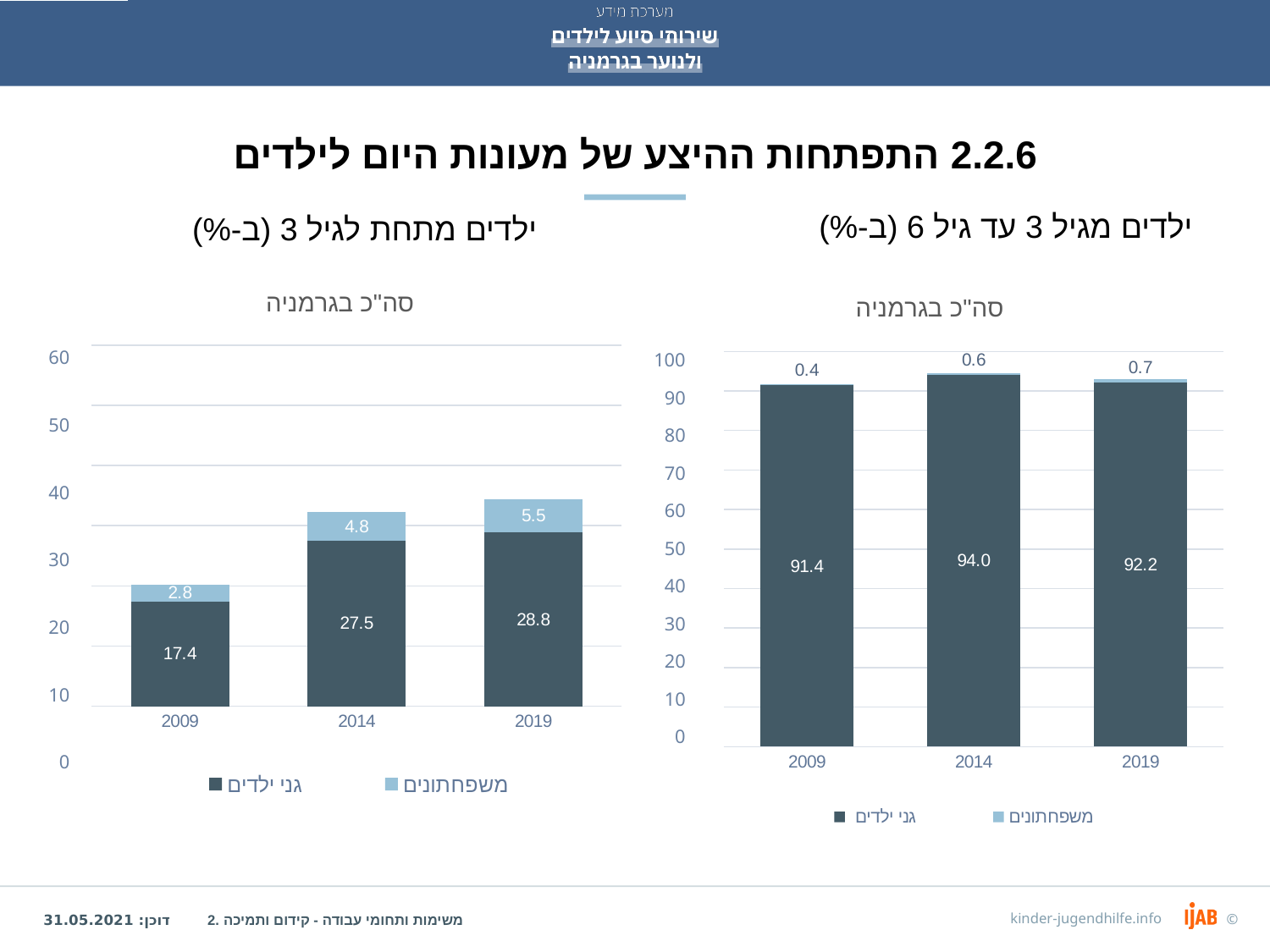
In the right chart (children aged 3 to 6), which year has the lowest value for גני ילדים? 2009 In the left chart (children under age 3), what is the value for גני ילדים in 2009? 17.4 In the right chart (children aged 3 to 6), is the גני ילדים value for 2014 larger or smaller than for 2019? larger In the left chart (children under age 3), which year has the highest value for גני ילדים? 2019 What type of chart is the right chart (children aged 3 to 6)? stacked bar chart How many years are shown on the x axis of the right chart (children aged 3 to 6)? 3 How many series does the legend of the left chart (children under age 3) list? 2 In the right chart (children aged 3 to 6), what is the value for משפחתונים in 2009? 0.4 In the left chart (children under age 3), what is the total of the stacked bar for 2019? 34.3 In the left chart (children under age 3), what is the difference between the גני ילדים values for 2014 and 2009? 10.1 In the right chart (children aged 3 to 6), what is the value for גני ילדים in 2014? 94.0 In the left chart (children under age 3), what is the value for משפחתונים in 2019? 5.5